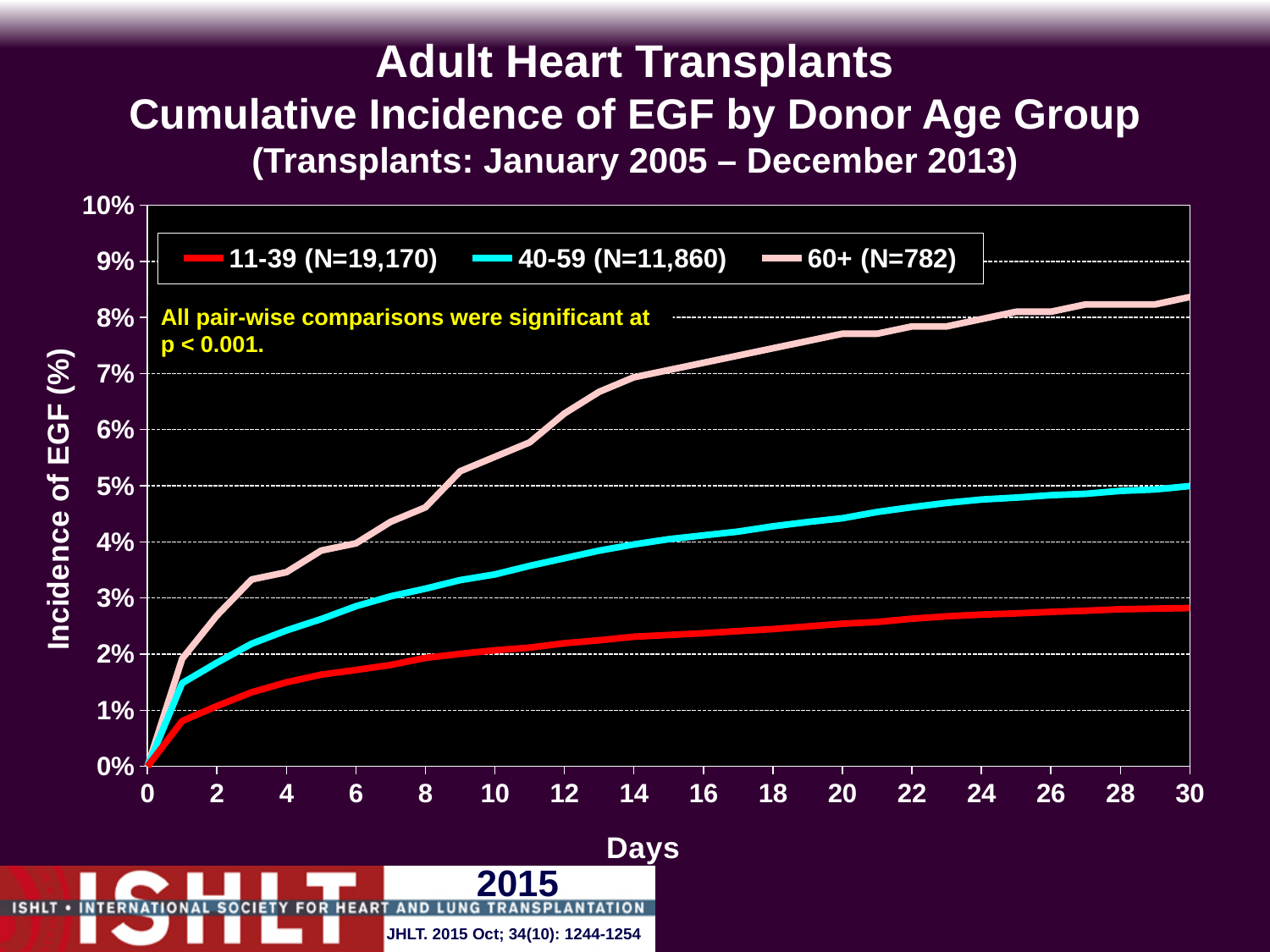
Which donor age group has the lowest cumulative incidence of EGF at day 30? 11-39 (N=19,170) How many series does the legend list? 3 Is the incidence of EGF for the 60+ group at day 30 greater or less than 8%? greater Is the incidence of EGF for the 60+ group at day 10 greater or less than 5%? greater What kind of chart is shown on the slide? line chart Do the cumulative incidence curves rise or fall as the number of days increases? rise Which donor age group has the highest cumulative incidence of EGF at day 30? 60+ (N=782) What is the label of the y axis? Incidence of EGF (%) Is the incidence of EGF for the 40-59 group at day 20 greater or less than 4%? greater What is the N for the 60+ donor age group shown in the legend? 782 At day 20, which has the larger incidence of EGF: the 40-59 group or the 11-39 group? 40-59 (N=11,860)